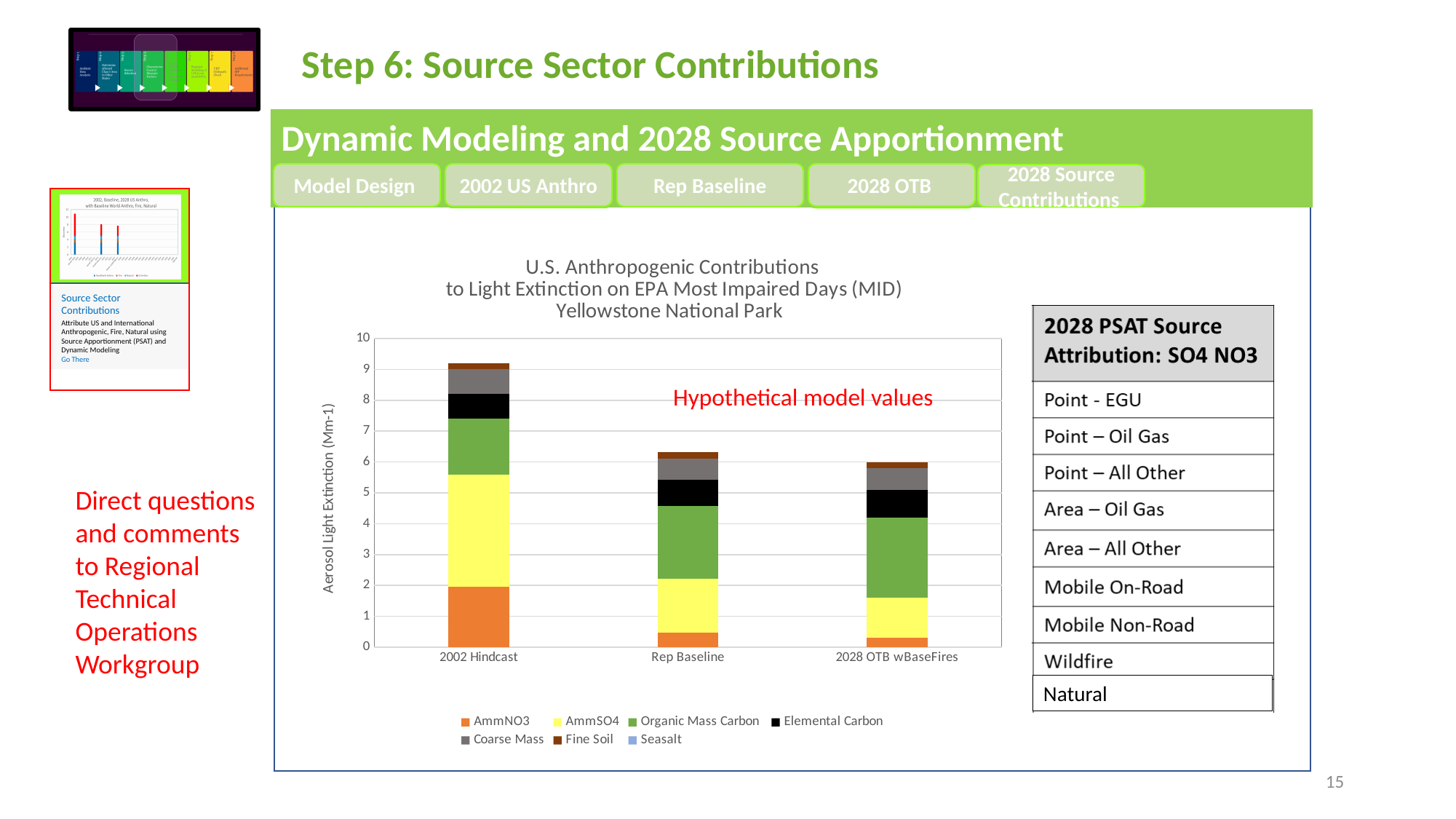
What is the label on the chart's y axis? Aerosol Light Extinction (Mm-1) Which has the larger total stacked bar, 2002 Hindcast or Rep Baseline? 2002 Hindcast How many series does the chart's legend list? 7 What kind of chart is shown on the slide? Stacked bar chart Is the total stacked bar for 2028 OTB wBaseFires greater or less than 7? less Is the total stacked bar for 2002 Hindcast greater or less than 8? greater Do the total stacked bar heights rise or fall from 2002 Hindcast to 2028 OTB wBaseFires? fall Which category has the tallest stacked bar? 2002 Hindcast How many categories are shown on the x axis of the chart? 3 Is the AmmSO4 segment for 2002 Hindcast greater or less than 3? greater Which colour represents AmmNO3 in the chart's legend? Orange